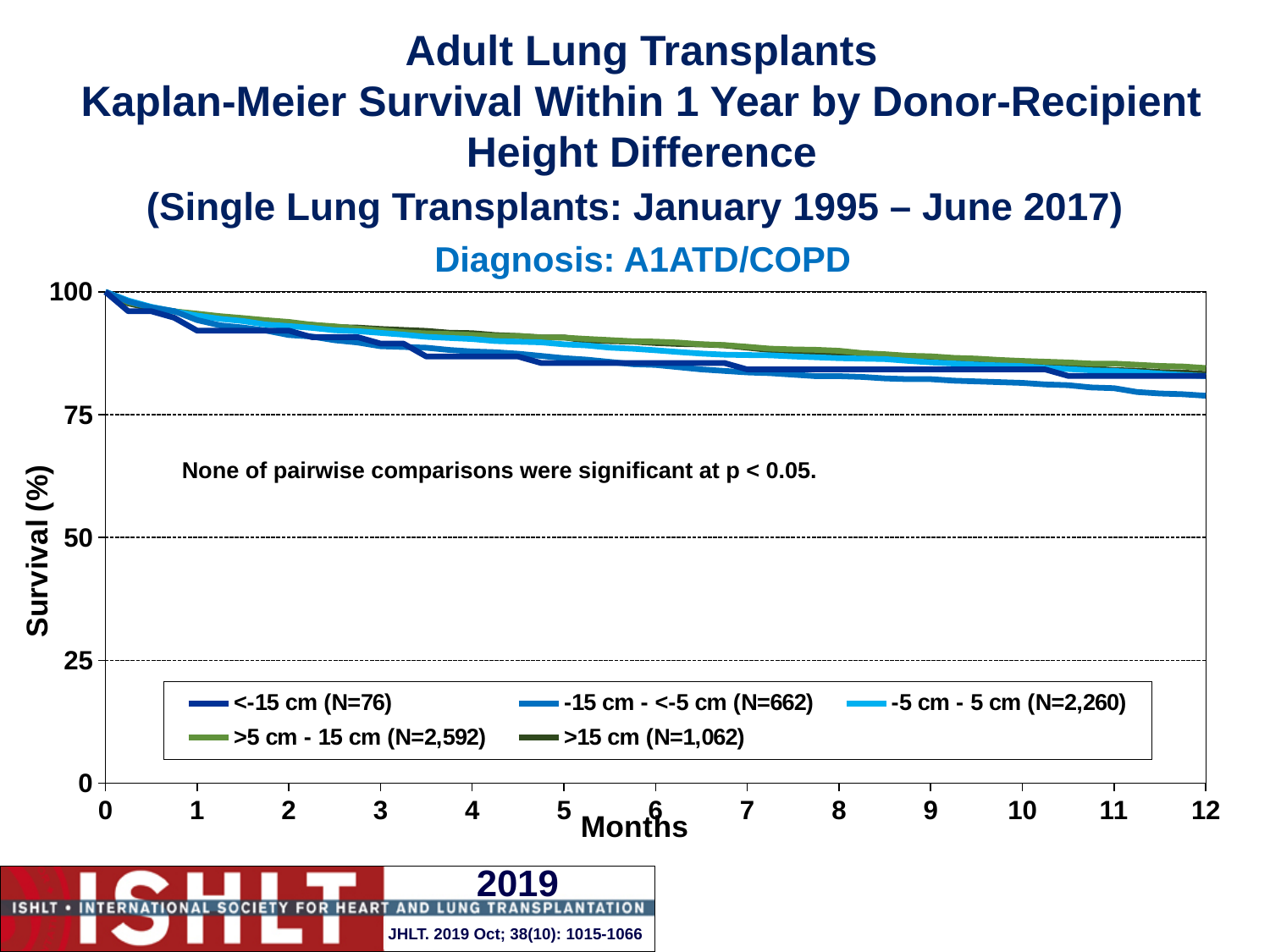
What kind of chart is shown on the slide? Line chart What is the N for the -5 cm - 5 cm height difference group shown in the legend? N=2,260 Is the survival for the >15 cm group at 12 months greater or less than 100? less Which height difference group has the lowest survival at 12 months? -15 cm - <-5 cm (N=662) How many series does the legend list? 5 Is the survival for the <-15 cm group at 12 months greater or less than 75? greater What diagnosis is stated in the chart subtitle? A1ATD/COPD What is the label of the x axis? Months What is the N for the >5 cm - 15 cm height difference group shown in the legend? N=2,592 What is the N for the <-15 cm height difference group shown in the legend? N=76 What is the survival (%) for all groups at month 0? 100 Do the survival curves rise or fall as months increase? Fall